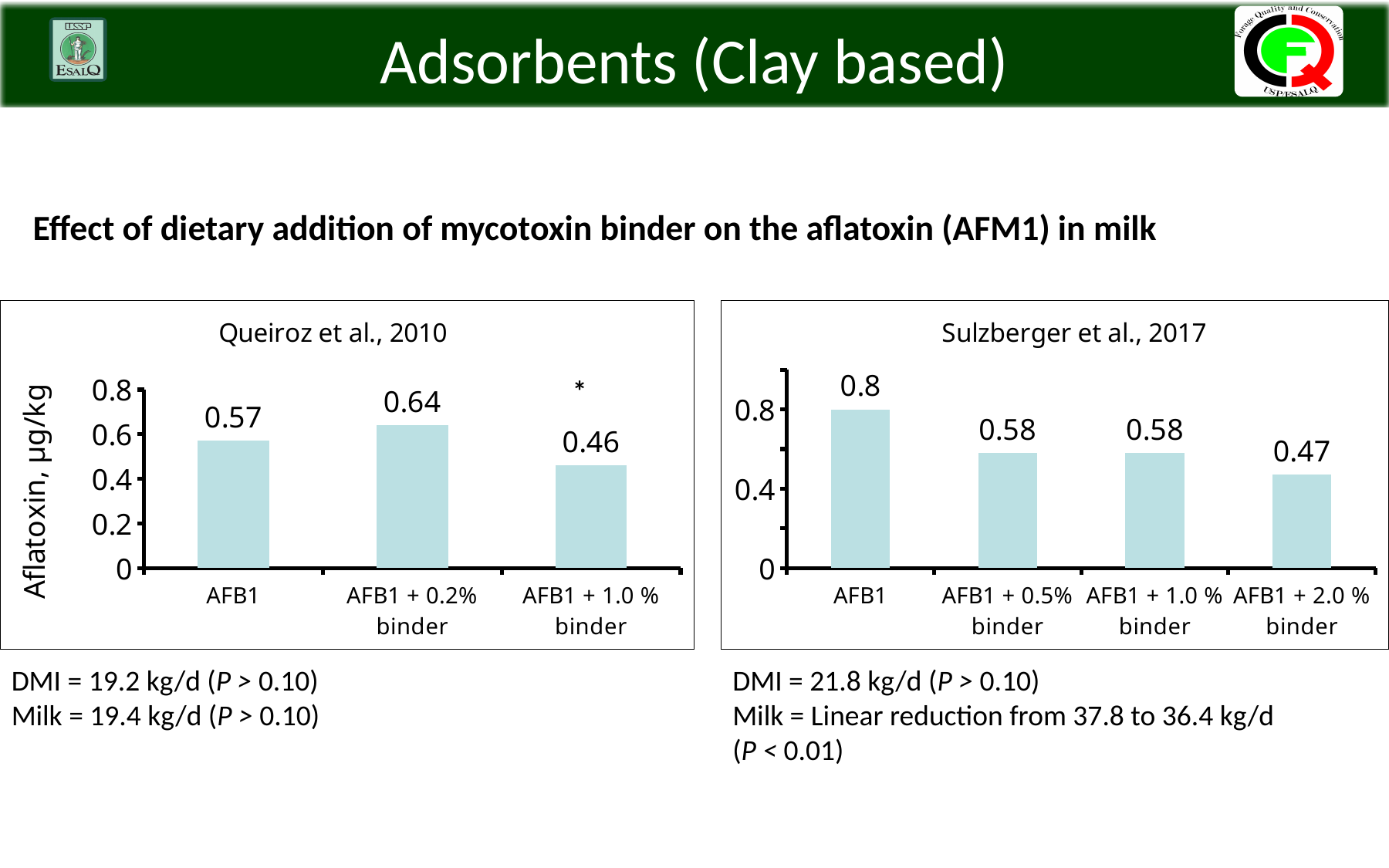
What kind of chart is the Queiroz et al., 2010 chart? bar chart In the Sulzberger et al., 2017 chart, what is the aflatoxin value for AFB1? 0.8 In the Queiroz et al., 2010 chart, how many categories are plotted? 3 In the Queiroz et al., 2010 chart, which category has the lowest aflatoxin value? AFB1 + 1.0 % binder In the Sulzberger et al., 2017 chart, how many categories are plotted? 4 In the Sulzberger et al., 2017 chart, what is the difference between the AFB1 value and the AFB1 + 0.5% binder value? 0.22 In the Sulzberger et al., 2017 chart, do the values rise or fall from left to right across the categories? fall In the Queiroz et al., 2010 chart, which category has the highest aflatoxin value? AFB1 + 0.2% binder In the Sulzberger et al., 2017 chart, what is the aflatoxin value for AFB1 + 2.0 % binder? 0.47 In the Queiroz et al., 2010 chart, what is the aflatoxin value for AFB1 + 0.2% binder? 0.64 In the Queiroz et al., 2010 chart, what is the difference between the AFB1 value and the AFB1 + 1.0 % binder value? 0.11 In the Sulzberger et al., 2017 chart, which category has the highest aflatoxin value? AFB1